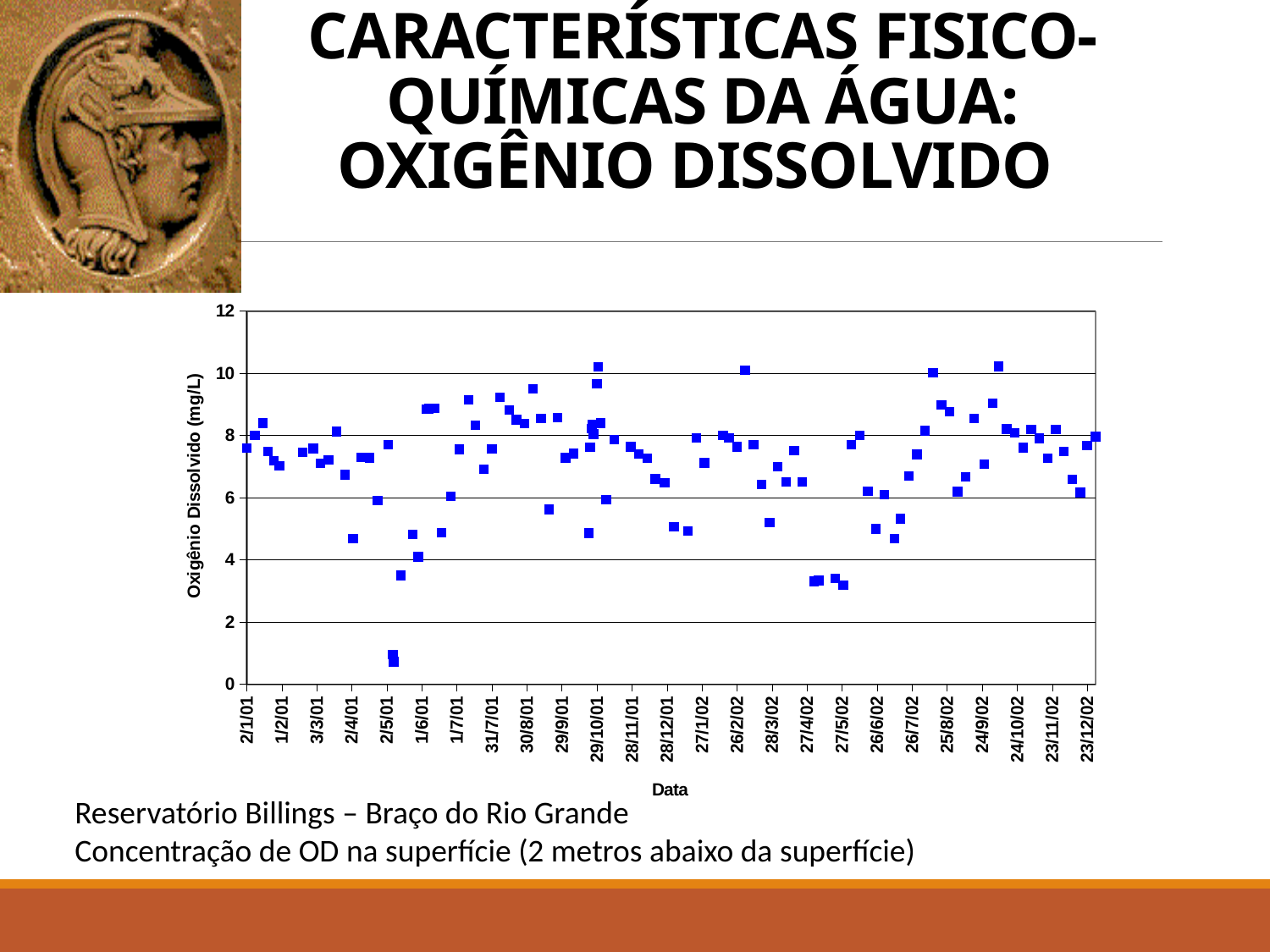
What is the label of the x axis of the chart? Data Is the lowest plotted value in the chart greater or less than 2? less How many date labels are shown on the x axis of the chart? 25 What kind of chart is shown on the slide? scatter chart Is the value plotted at 2/1/01 greater or less than 6? greater What is the last date label on the x axis of the chart? 23/12/02 Is the highest plotted value in the chart greater or less than 10? greater What is the label of the y axis of the chart? Oxigênio Dissolvido (mg/L) What is the highest value shown on the y axis of the chart? 12 What is the first date label on the x axis of the chart? 2/1/01